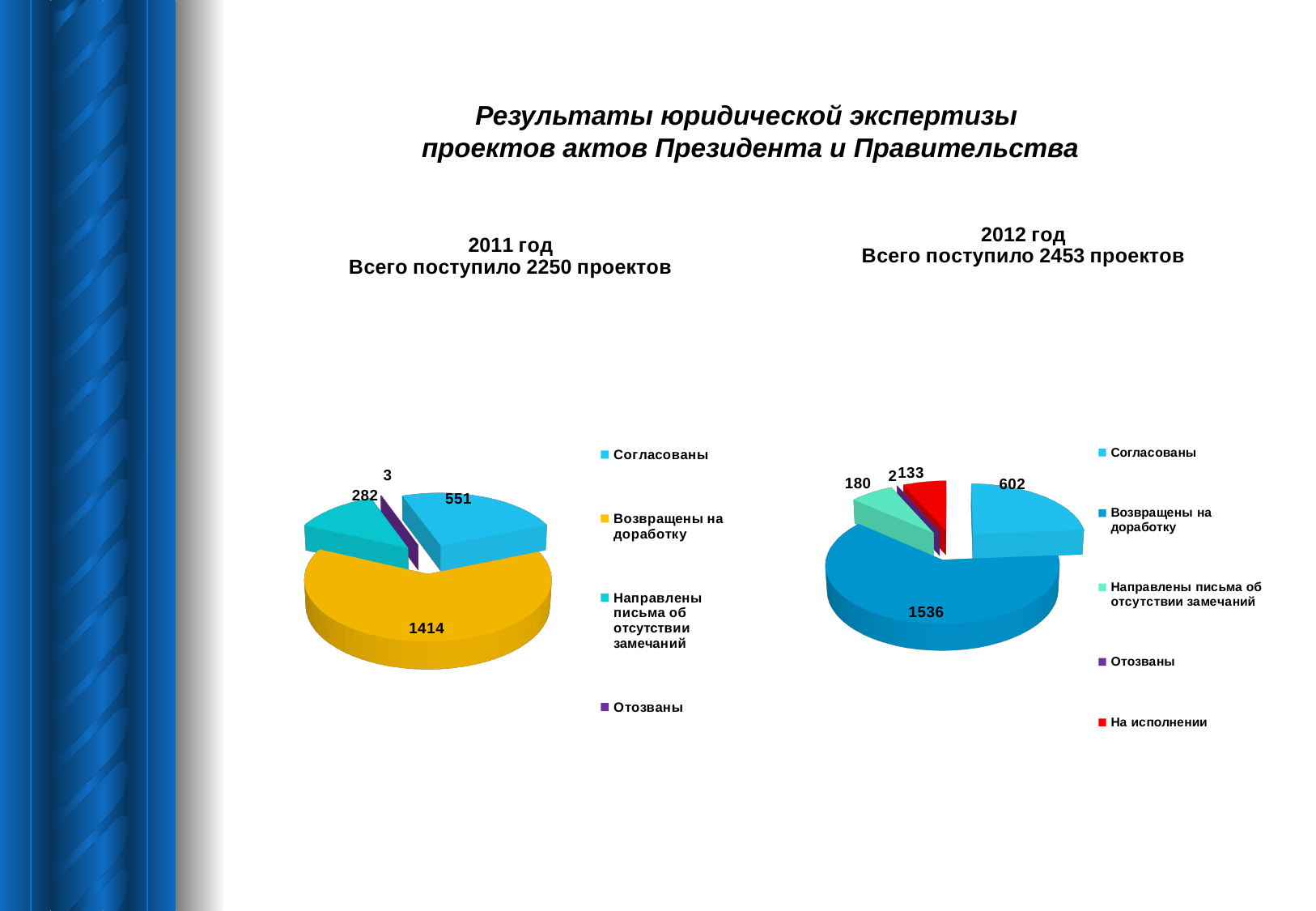
In the 2011 год chart, which category has the smallest slice? Отозваны In the 2011 год chart, what is the difference between Возвращены на доработку and Согласованы? 863 In the 2012 год chart, which category has the largest slice? Возвращены на доработку In the 2011 год chart, how many projects were Возвращены на доработку? 1414 How many categories does the legend of the 2012 год chart list? 5 How many slices does the 2011 год chart have? 4 Which is larger: Согласованы in the 2011 год chart or Согласованы in the 2012 год chart? 2012 год In the 2012 год chart, how many projects were Согласованы? 602 What is the difference between the Возвращены на доработку values in the 2012 год chart and the 2011 год chart? 122 What type of chart is used for the 2011 год data? Pie chart In the 2011 год chart, what is the value for Направлены письма об отсутствии замечаний? 282 In the 2012 год chart, what is the value for На исполнении? 133